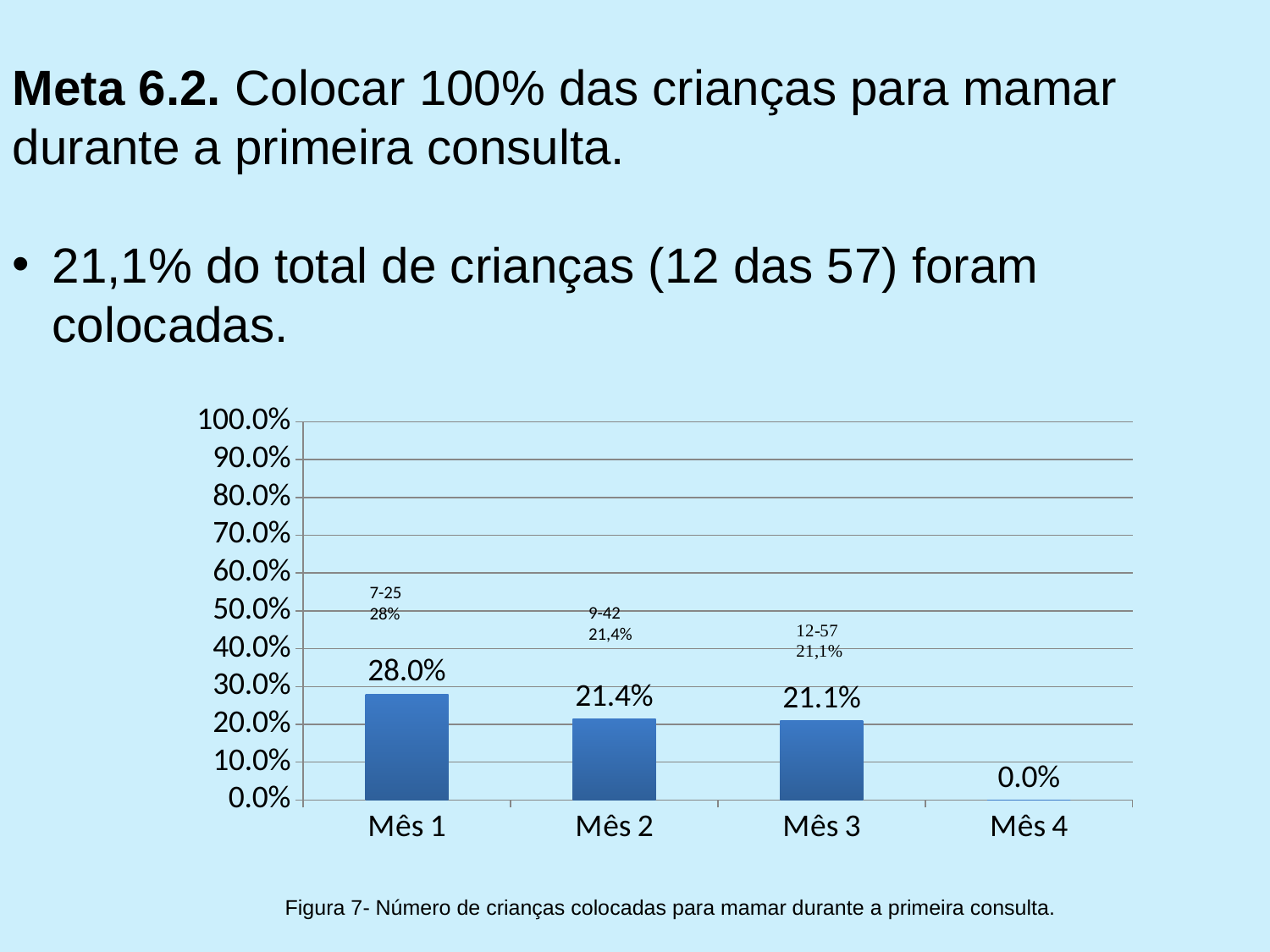
Is the value for Mês 1 greater or less than 30.0%? less Which month has the highest value? Mês 1 What is the value for Mês 1? 28.0% How many months are shown on the x axis? 4 What is the difference between the values for Mês 1 and Mês 2? 6.6% Which is larger, the value for Mês 1 or the value for Mês 3? Mês 1 What kind of chart is shown on the slide? Bar chart What is the value for Mês 2? 21.4% What is the value for Mês 3? 21.1% Which month has the lowest value? Mês 4 What is the value for Mês 4? 0.0% Do the values rise or fall from Mês 1 to Mês 4? Fall